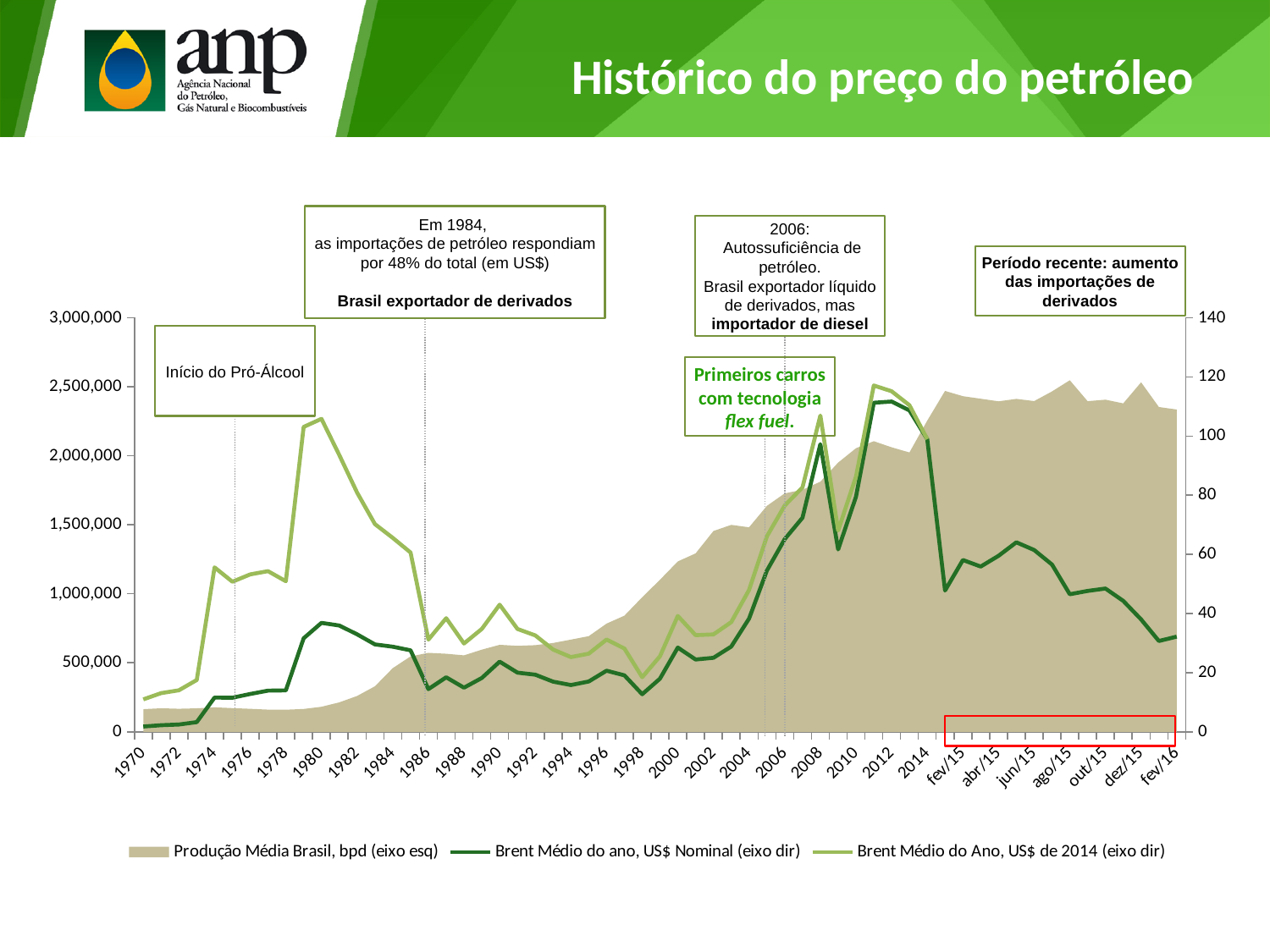
Which legend entry is plotted as the shaded area? Produção Média Brasil, bpd (eixo esq) What kind of chart is shown on the slide? Combined area and line chart Is the value of Produção Média Brasil in 2014 greater or less than 2,000,000? greater Is the value of Brent Médio do Ano, US$ de 2014 in 1980 greater or less than 80? greater Is the value of Produção Média Brasil in 1970 greater or less than 500,000? less Does Brent Médio do ano, US$ Nominal rise or fall from ago/15 to dez/15? fall What is the title of the slide containing the chart? Histórico do preço do petróleo Does Produção Média Brasil rise or fall from 1990 to 2010? rise How many series does the chart legend list? 3 In 1980, which is larger: Brent Médio do ano, US$ Nominal or Brent Médio do Ano, US$ de 2014? Brent Médio do Ano, US$ de 2014